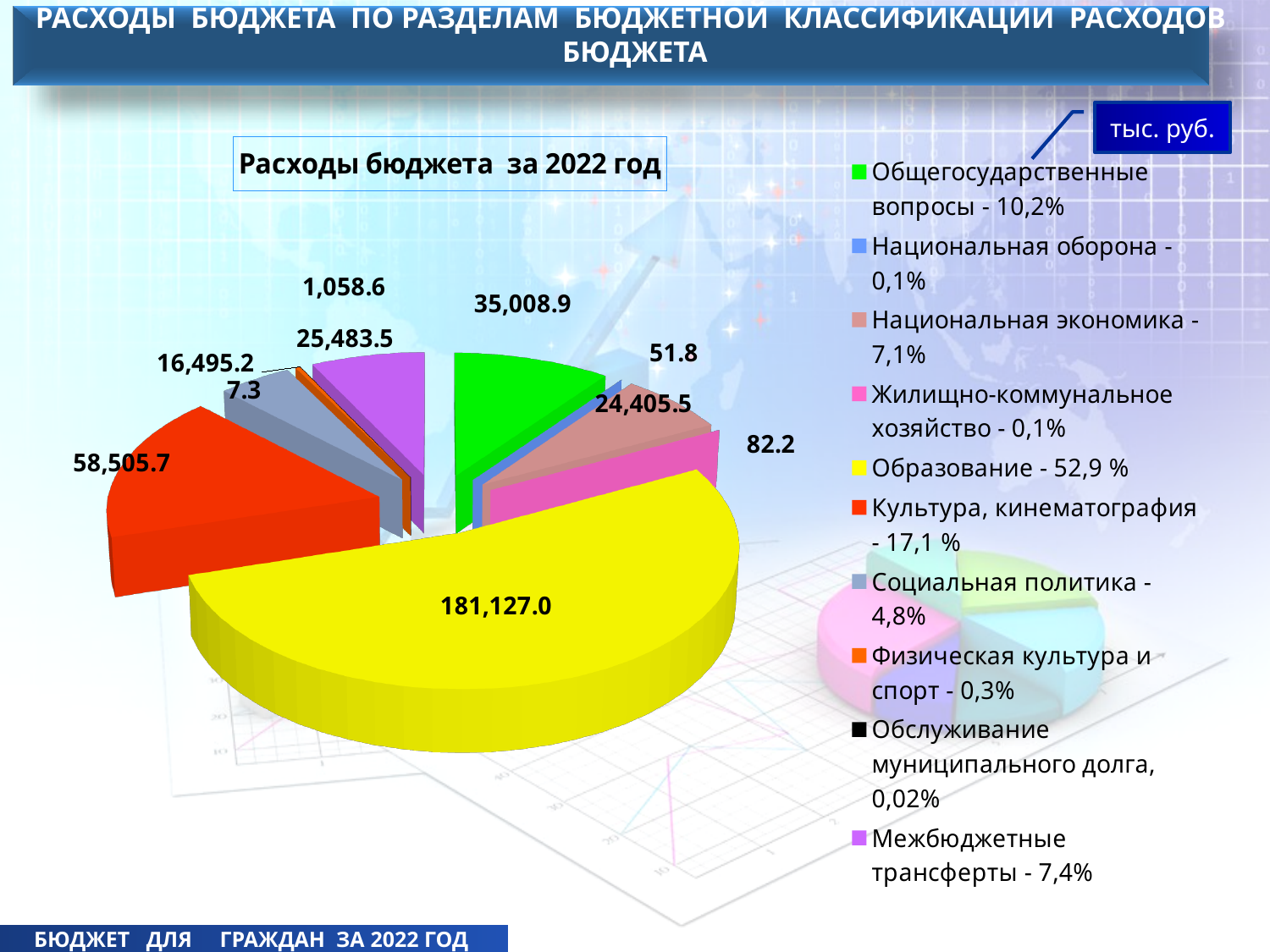
What is the difference between the values for Культура, кинематография and Общегосударственные вопросы? 23,496.8 What is the title of the chart? Расходы бюджета за 2022 год Which category has the largest slice of the pie? Образование Which is larger: Общегосударственные вопросы or Национальная экономика? Общегосударственные вопросы What is the value for Образование? 181,127.0 What share of the pie does Образование account for, according to the legend? 52,9 % What kind of chart is shown on the slide? pie chart What is the value for Межбюджетные трансферты? 25,483.5 How many categories does the chart's legend list? 10 What share of the pie does Социальная политика account for, according to the legend? 4,8% What is the value for Культура, кинематография? 58,505.7 Which category has the smallest share according to the legend? Обслуживание муниципального долга